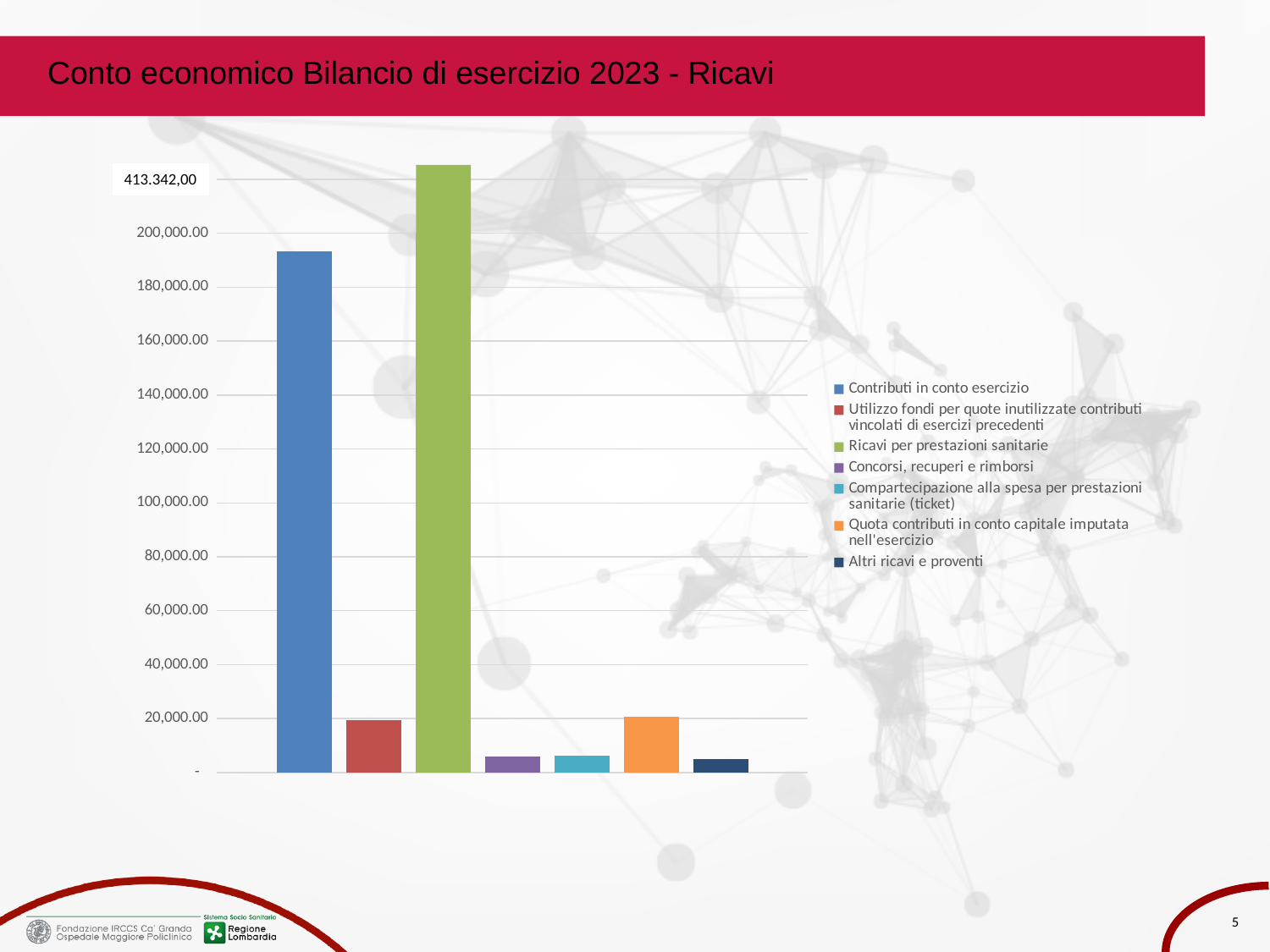
Is the value for Concorsi, recuperi e rimborsi greater or less than 20,000.00? less What colour is the bar for Ricavi per prestazioni sanitarie? Green Is the value for Contributi in conto esercizio greater or less than 180,000.00? greater Is the value for Contributi in conto esercizio greater or less than 200,000.00? less Which is larger: Contributi in conto esercizio or Utilizzo fondi per quote inutilizzate contributi vincolati di esercizi precedenti? Contributi in conto esercizio How many bars are plotted in the chart? 7 Which series has the highest value in the chart? Ricavi per prestazioni sanitarie What kind of chart is shown on the slide? Bar chart How many series does the legend list? 7 What is the title of the slide containing the chart? Conto economico Bilancio di esercizio 2023 - Ricavi Which is larger: Quota contributi in conto capitale imputata nell'esercizio or Altri ricavi e proventi? Quota contributi in conto capitale imputata nell'esercizio